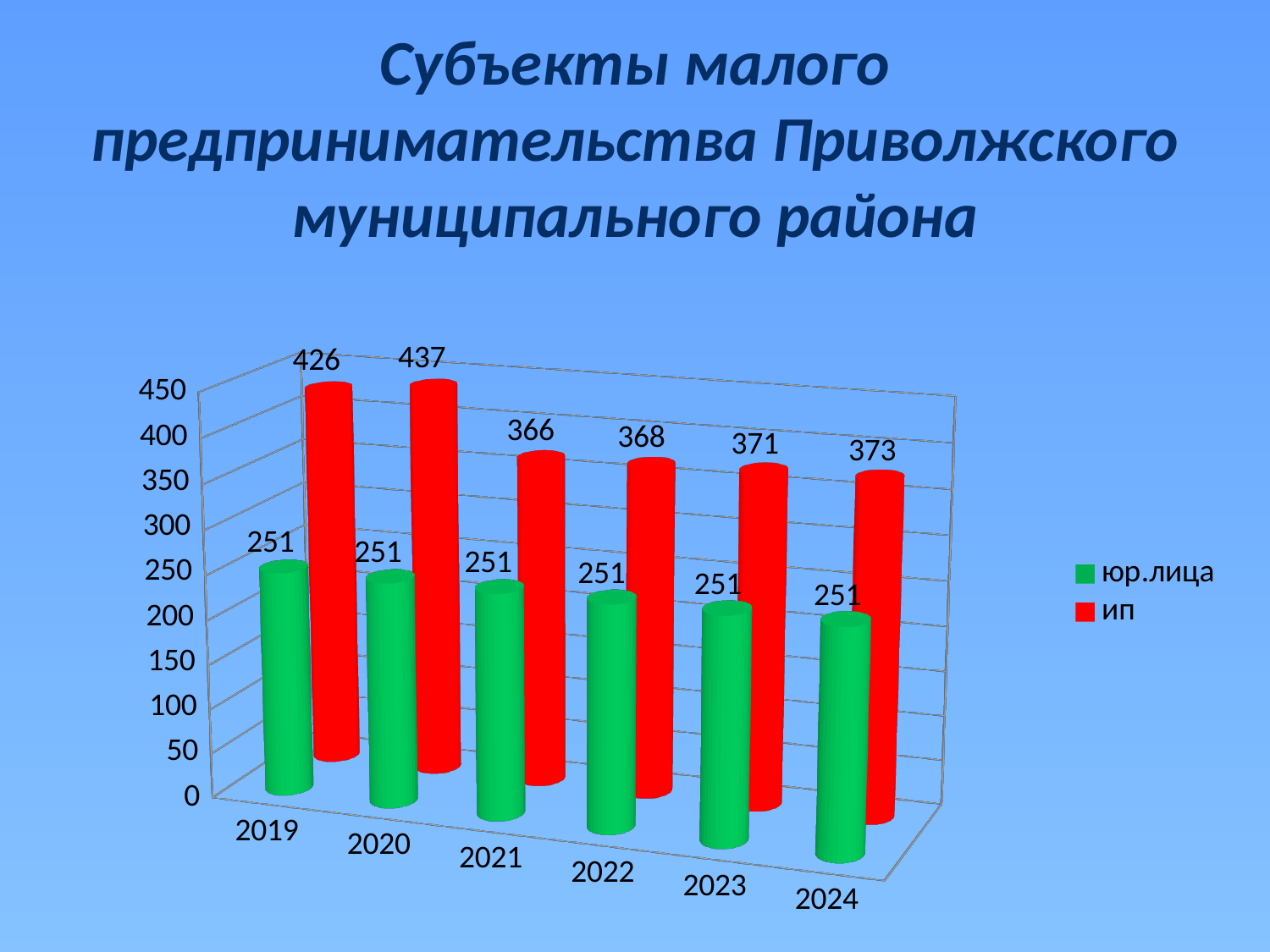
How many series does the legend list? 2 In which year is the value for ип lowest? 2021 Which is larger in 2023, ип or юр.лица? ип Which colour represents ип in the legend? red How many years are shown on the x axis? 6 What kind of chart is shown on the slide? bar chart What is the value for юр.лица in 2019? 251 In which year is the value for ип highest? 2020 What is the difference between ип and юр.лица in 2019? 175 What is the value for ип in 2020? 437 What is the difference between the ип values for 2020 and 2021? 71 What is the value for ип in 2024? 373